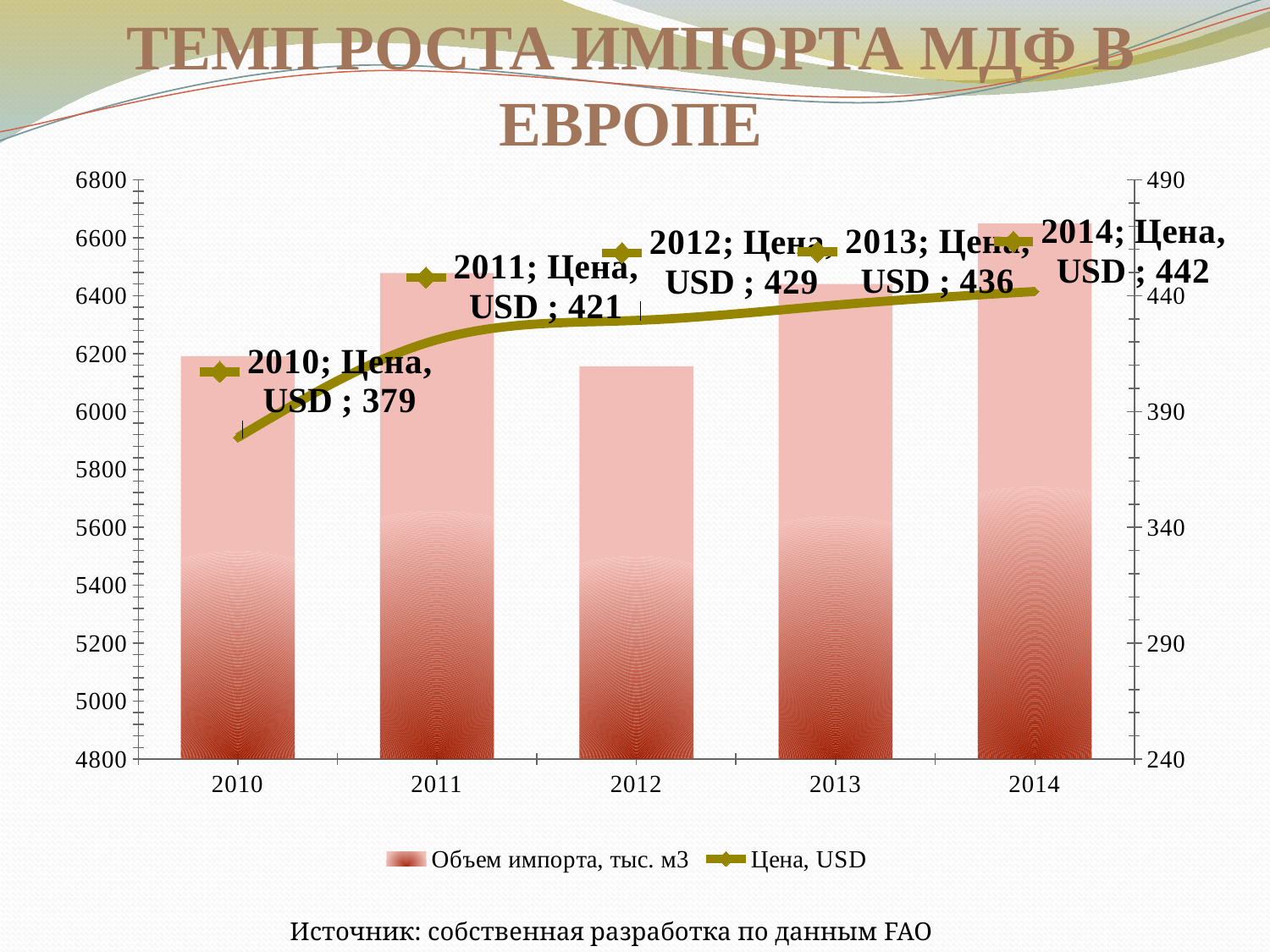
Which year has the tallest bar for Объем импорта, тыс. м3? 2014 What is the value of Цена, USD for 2010? 379 What is the difference between Цена, USD in 2014 and in 2010? 63 Is the value of Объем импорта, тыс. м3 for 2012 greater or less than 6400? less In which year is Цена, USD highest? 2014 How many series does the legend list? 2 Which year has the higher Цена, USD: 2012 or 2013? 2013 Is the value of Объем импорта, тыс. м3 for 2011 greater or less than 6400? greater What is the value of Цена, USD for 2013? 436 In which year is Цена, USD lowest? 2010 What is the difference between Цена, USD in 2011 and in 2010? 42 How many years are shown on the x axis? 5